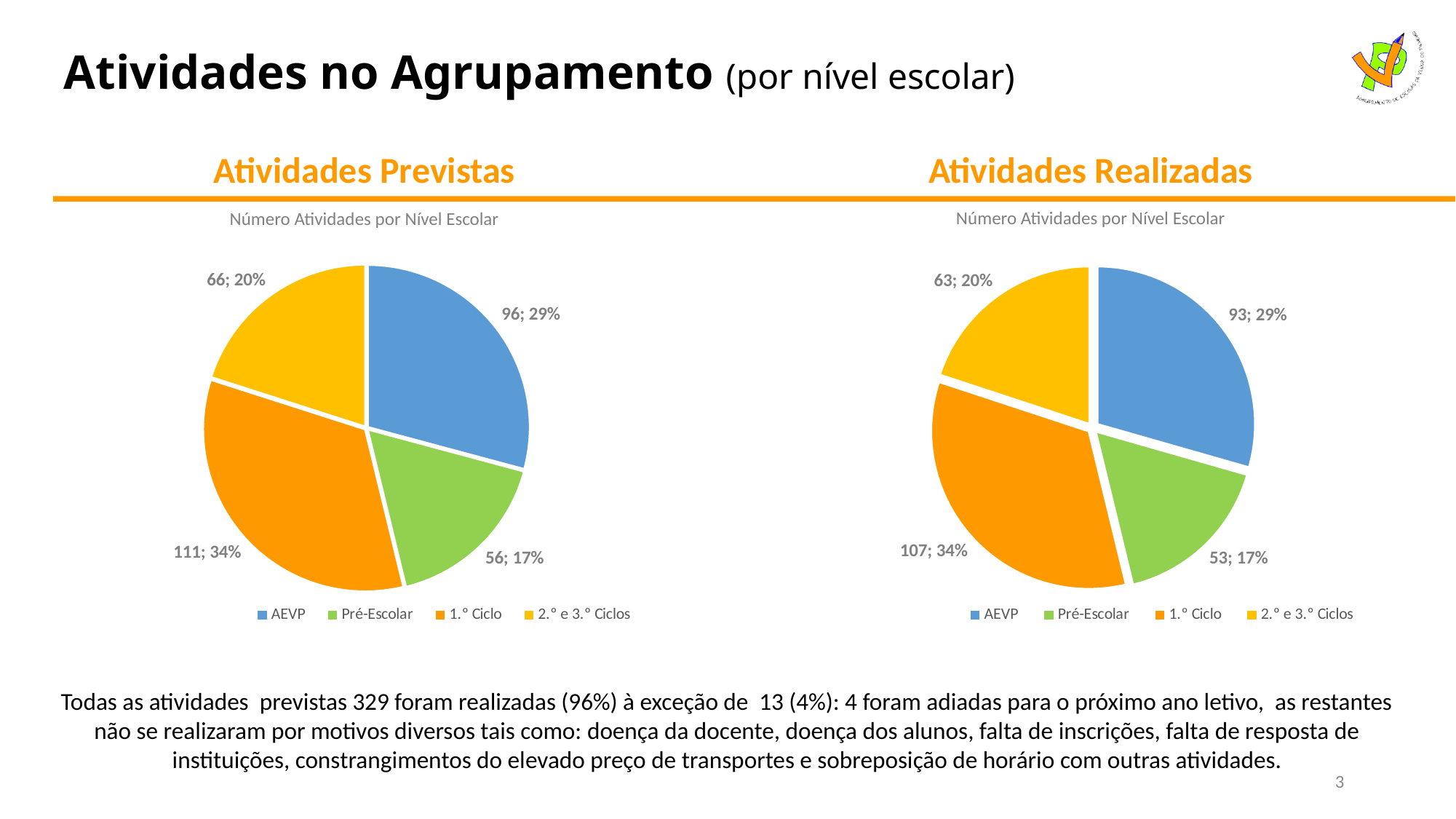
In the Atividades Previstas chart on the left, what is the difference between the values for 1.º Ciclo and AEVP? 15 In the Atividades Realizadas chart on the right, which category has the smallest slice? Pré-Escolar In the Atividades Previstas chart on the left, what share of the pie does 2.º e 3.º Ciclos represent? 20% In the Atividades Previstas chart on the left, what is the value for 1.º Ciclo? 111 What type of chart is the Atividades Realizadas chart on the right? Pie chart In the Atividades Realizadas chart on the right, what is the value for AEVP? 93 In the Atividades Realizadas chart on the right, which colour represents Pré-Escolar? Green Which is larger: the value for AEVP in the Atividades Previstas chart or the value for AEVP in the Atividades Realizadas chart? Atividades Previstas In the Atividades Previstas chart on the left, which category has the largest slice? 1.º Ciclo In the Atividades Realizadas chart on the right, what is the difference between the values for 2.º e 3.º Ciclos and Pré-Escolar? 10 In the Atividades Realizadas chart on the right, what share of the pie does 1.º Ciclo represent? 34% How many categories are shown in the Atividades Previstas chart on the left? 4